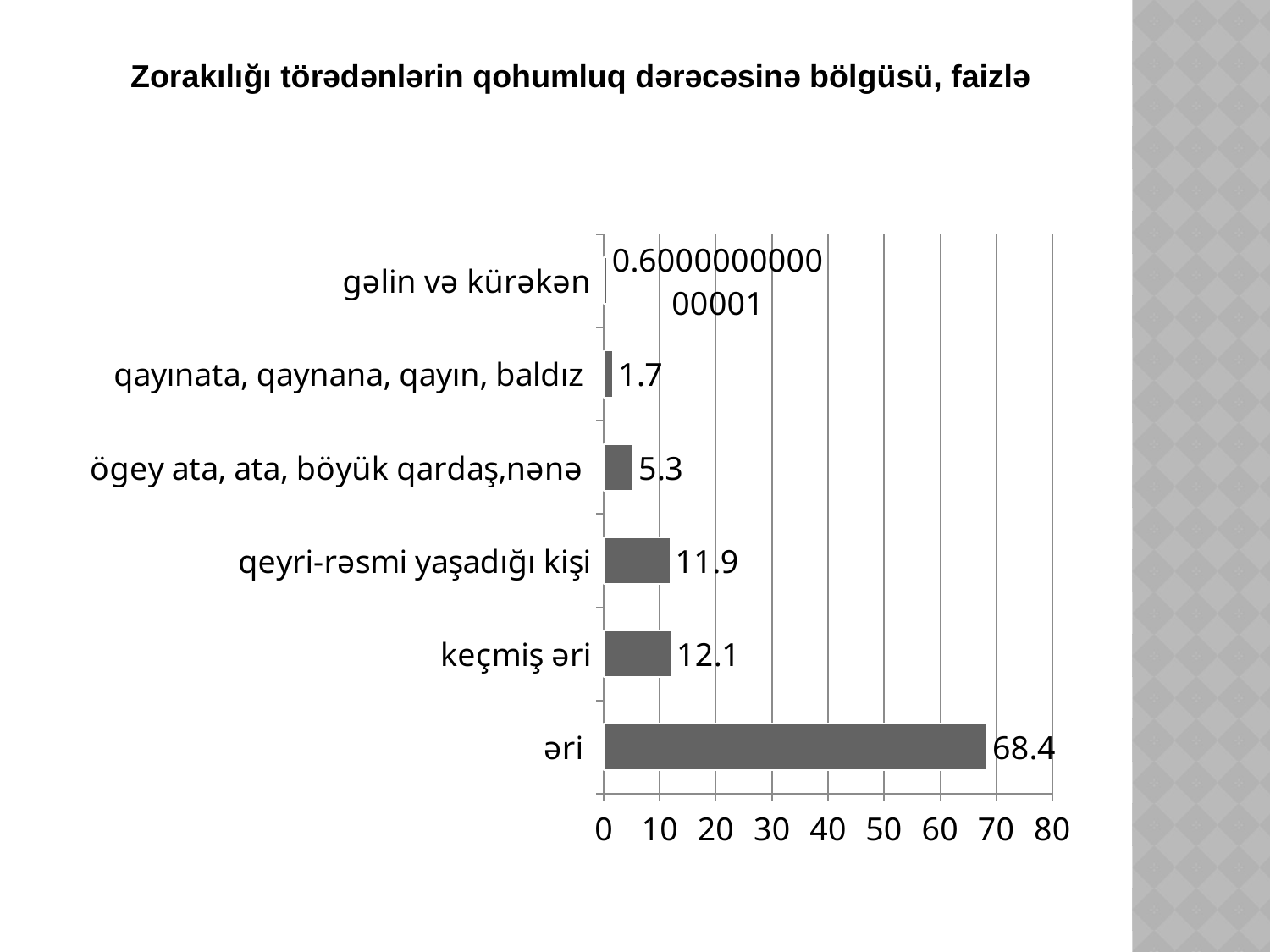
Is the value for əri greater or less than 60? greater What is the difference between the values for əri and keçmiş əri? 56.3 Which category has the highest value? əri What is the value for əri? 68.4 What is the title of the chart? Zorakılığı törədənlərin qohumluq dərəcəsinə bölgüsü, faizlə What is the value for ögey ata, ata, böyük qardaş,nənə? 5.3 What is the value for keçmiş əri? 12.1 Which category has the lowest value? gəlin və kürəkən What type of chart is shown on the slide? bar chart What is the value for qeyri-rəsmi yaşadığı kişi? 11.9 How many categories are shown in the chart? 6 What is the value for qayınata, qaynana, qayın, baldız? 1.7